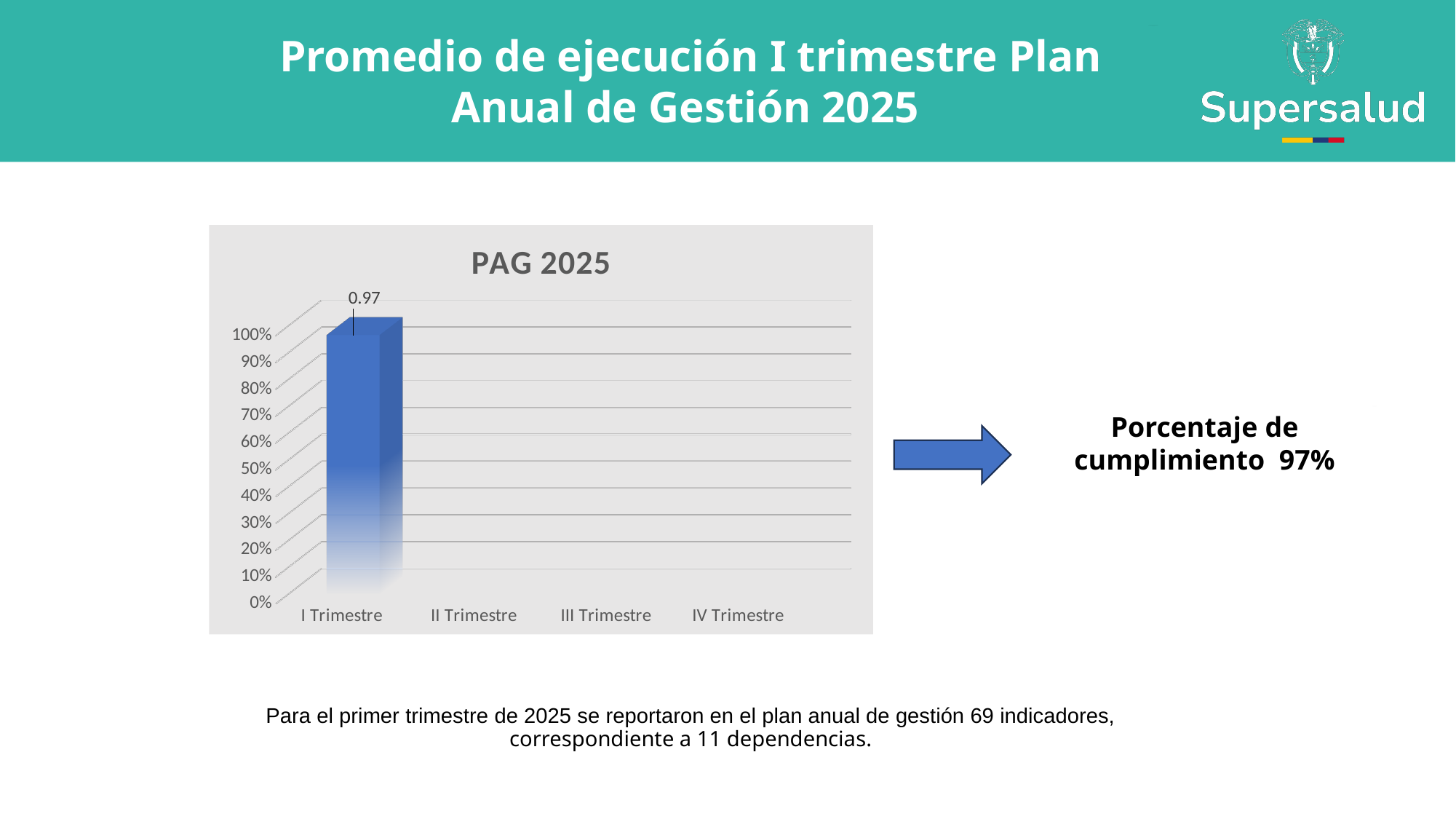
Is the value for I Trimestre in the PAG 2025 chart greater or less than 50%? greater Which categories in the PAG 2025 chart have no bar plotted? II Trimestre, III Trimestre, IV Trimestre What is the highest tick label on the y axis of the PAG 2025 chart? 100% What is the label of the last category on the x axis of the PAG 2025 chart? IV Trimestre Which category has the highest value in the PAG 2025 chart? I Trimestre What is the data label shown on the bar for I Trimestre in the PAG 2025 chart? 0.97 How many categories are shown on the x axis of the PAG 2025 chart? 4 What kind of chart is the PAG 2025 chart? bar chart What is the title of the chart on the slide? PAG 2025 What is the label of the first category on the x axis of the PAG 2025 chart? I Trimestre How many bars are actually plotted in the PAG 2025 chart? 1 Is the value for I Trimestre in the PAG 2025 chart greater or less than 90%? greater